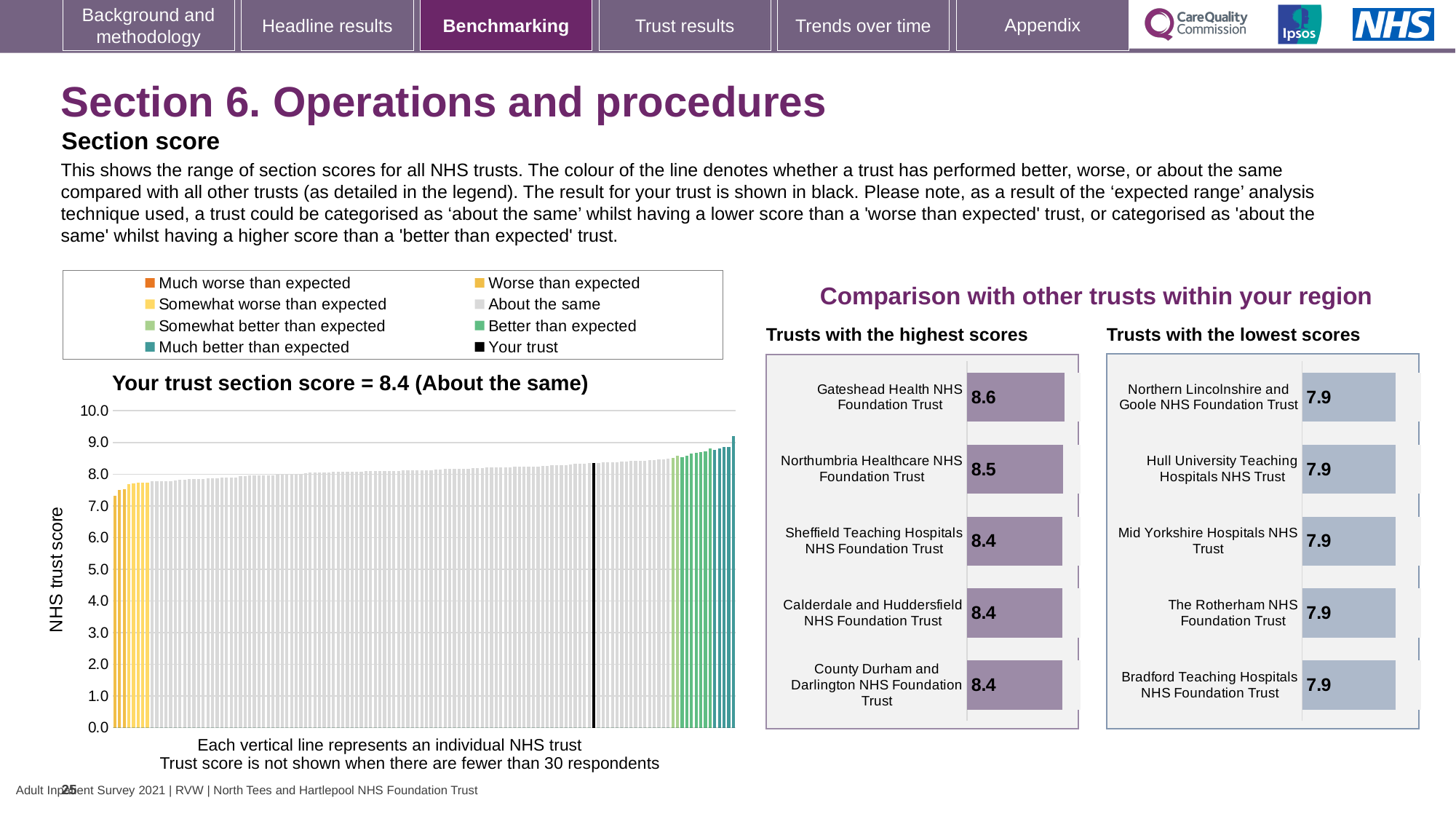
In the chart titled 'Your trust section score', is the value of the leftmost bar greater or less than 8.0? less In the chart titled 'Your trust section score', which category is your trust placed in? About the same In the chart titled 'Your trust section score', do the trust scores rise or fall from left to right along the x axis? rise Which is larger: the score for Gateshead Health NHS Foundation Trust in the 'Trusts with the highest scores' chart or the score for Bradford Teaching Hospitals NHS Foundation Trust in the 'Trusts with the lowest scores' chart? Gateshead Health NHS Foundation Trust How many entries does the legend above the 'Your trust section score' chart list? 8 In the 'Trusts with the highest scores' chart, which trust has the highest score? Gateshead Health NHS Foundation Trust In the 'Trusts with the highest scores' chart, what is the difference between the scores of Gateshead Health NHS Foundation Trust and Northumbria Healthcare NHS Foundation Trust? 0.1 In the chart titled 'Your trust section score', what is the section score for your trust? 8.4 What kind of chart is the chart titled 'Your trust section score'? bar chart In the 'Trusts with the highest scores' chart, what is the score for Gateshead Health NHS Foundation Trust? 8.6 In the 'Trusts with the lowest scores' chart, what is the score for Mid Yorkshire Hospitals NHS Trust? 7.9 How many trusts are shown in the 'Trusts with the lowest scores' chart? 5